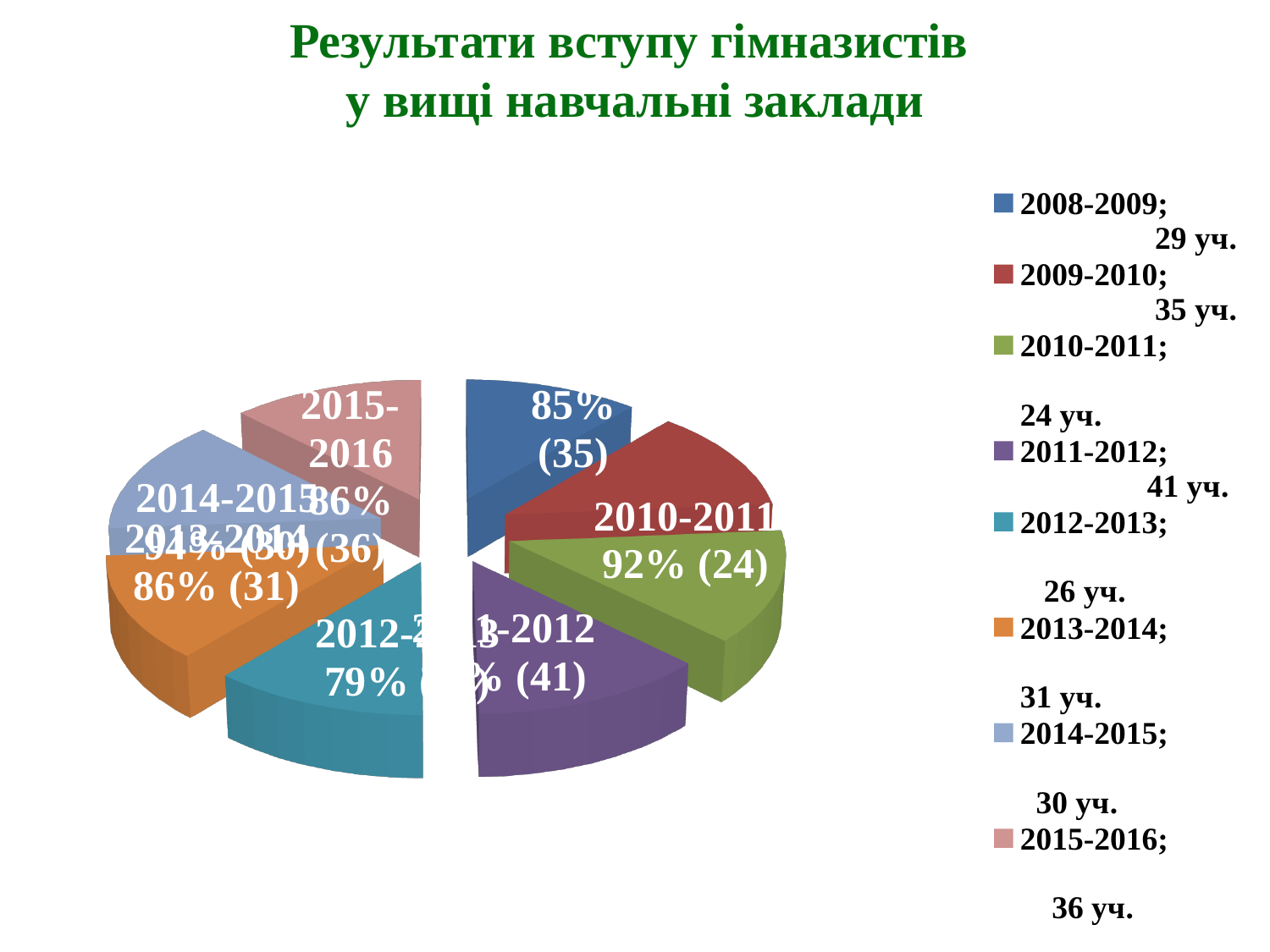
What kind of chart is shown on the slide? pie chart Which has more students, 2009-2010 or 2008-2009? 2009-2010 How many categories (school years) does the pie chart show? 8 According to the legend, how many students are listed for 2012-2013? 26 уч. Which school year has the highest number of students in the legend? 2011-2012 What percentage is shown on the data label for 2010-2011? 92% What is the difference between the number of students for 2011-2012 and 2010-2011? 17 According to the legend, how many students are listed for 2011-2012? 41 уч. Which school year has the lowest number of students in the legend? 2010-2011 According to the legend, how many students are listed for 2008-2009? 29 уч. What percentage is shown on the data label for 2013-2014? 86% What is the title of the chart on the slide? Результати вступу гімназистів у вищі навчальні заклади